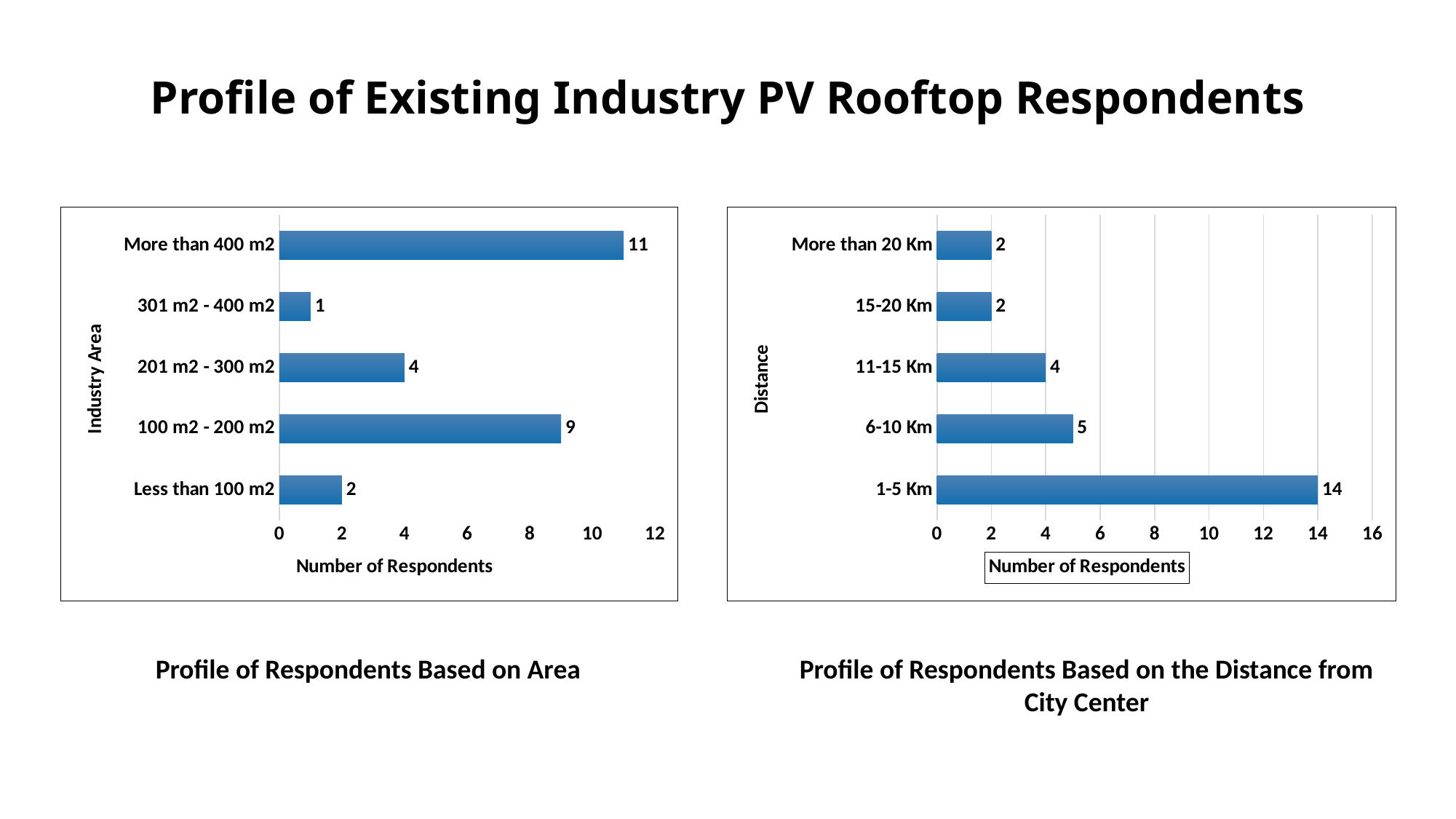
In the 'Profile of Respondents Based on the Distance from City Center' chart, what is the difference in respondents between the 1-5 Km and 11-15 Km categories? 10 In the 'Profile of Respondents Based on the Distance from City Center' chart, what is the label of the x axis? Number of Respondents In the 'Profile of Respondents Based on Area' chart, how many industry area categories are shown? 5 In the 'Profile of Respondents Based on Area' chart, what is the label of the y axis? Industry Area In the 'Profile of Respondents Based on the Distance from City Center' chart, which distance category has the most respondents? 1-5 Km What type of chart is the 'Profile of Respondents Based on the Distance from City Center' chart? Bar chart In the 'Profile of Respondents Based on the Distance from City Center' chart, how many respondents are located 1-5 Km from the city center? 14 In the 'Profile of Respondents Based on Area' chart, how many respondents have an industry area of more than 400 m2? 11 In the 'Profile of Respondents Based on Area' chart, what is the difference in respondents between the 100 m2 - 200 m2 and 201 m2 - 300 m2 categories? 5 In the 'Profile of Respondents Based on Area' chart, which industry area category has the fewest respondents? 301 m2 - 400 m2 In the 'Profile of Respondents Based on the Distance from City Center' chart, how many respondents are in the 6-10 Km category? 5 In the 'Profile of Respondents Based on Area' chart, which has more respondents: Less than 100 m2 or 201 m2 - 300 m2? 201 m2 - 300 m2